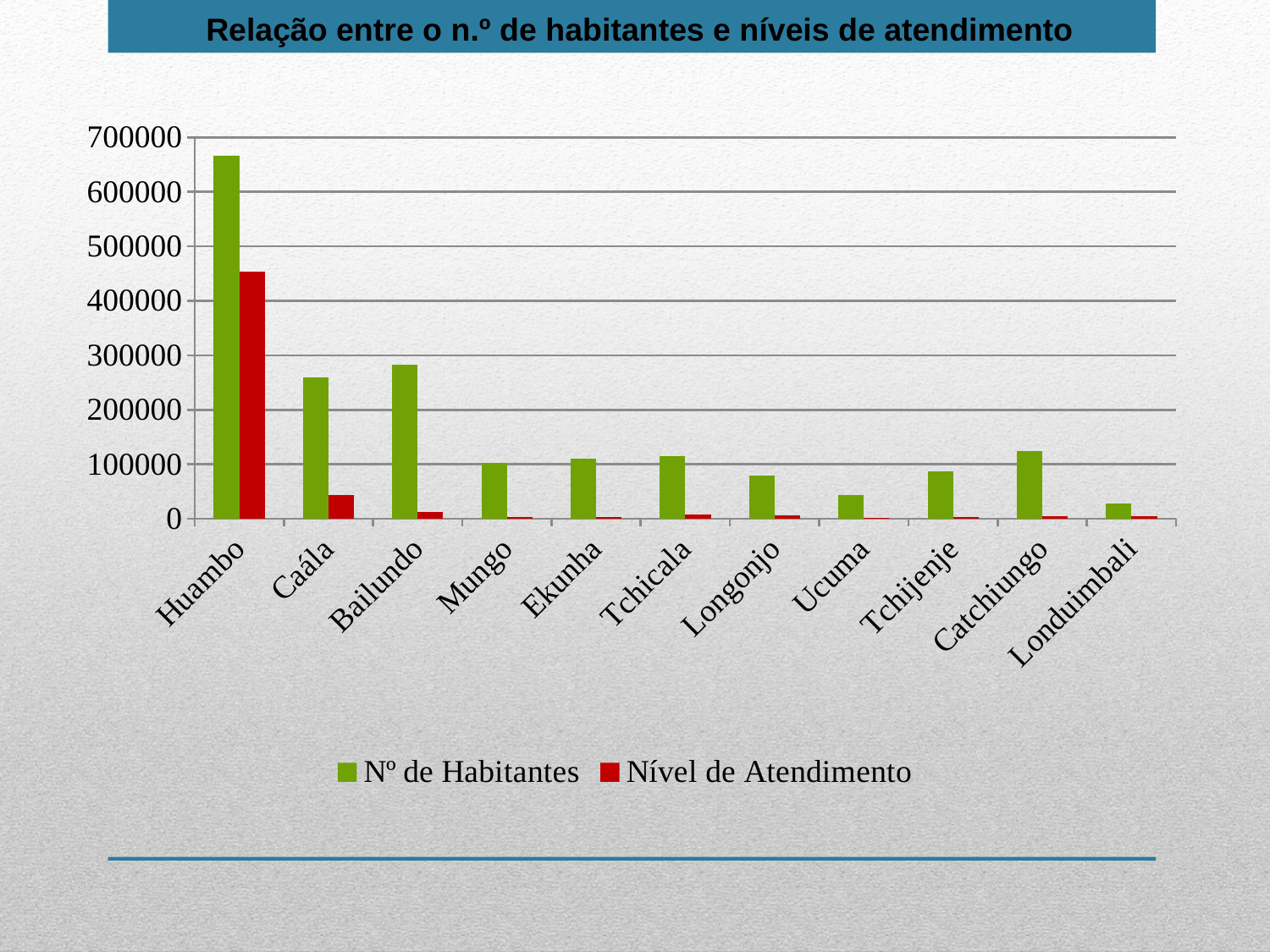
Is the Nº de Habitantes value for Bailundo greater or less than 300000? less Is the Nº de Habitantes value for Huambo greater or less than 600000? greater Which category has the highest value for Nível de Atendimento? Huambo How many municipalities (categories) are shown on the x axis? 11 What colour are the bars for the Nível de Atendimento series? red What kind of chart is shown on the slide? bar chart How many series does the legend list? 2 Which category has the lowest value for Nº de Habitantes? Londuimbali Is the Nível de Atendimento value for Huambo greater or less than 400000? greater Which has a larger Nº de Habitantes value, Bailundo or Caála? Bailundo Which category has the highest value for Nº de Habitantes? Huambo